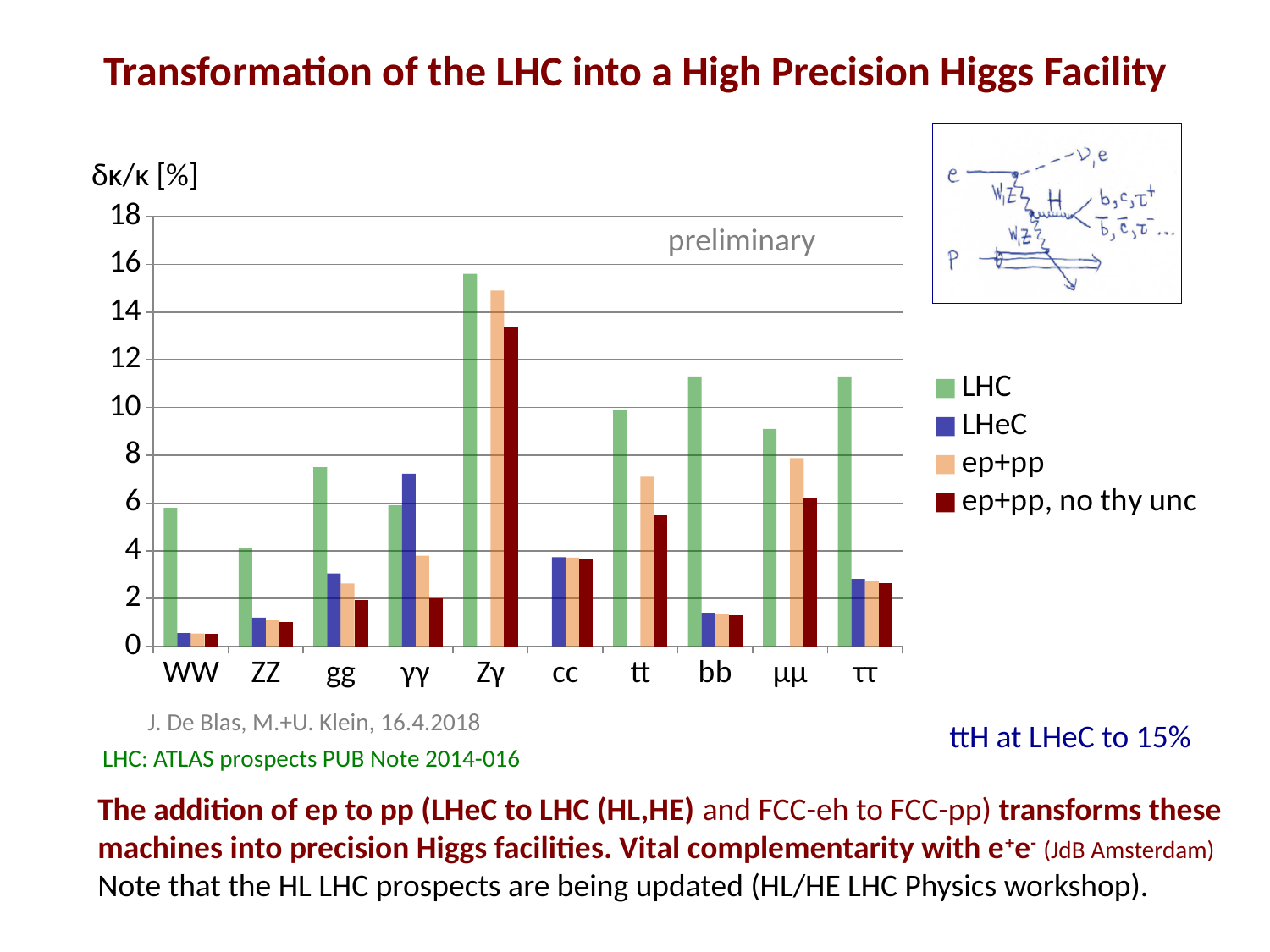
For which category is the LHC value highest? Zγ What is the label on the y axis of the chart? δκ/κ [%] How many series does the chart legend list? 4 Is the LHC value for Zγ greater or less than 14? greater What kind of chart is shown on the slide? bar chart How many categories are shown along the x axis of the chart? 10 For gg, which is larger: the LHC value or the LHeC value? LHC Is the LHC value for bb greater or less than 10? greater Which is larger: the LHC value for tt or the LHC value for bb? bb Is the ep+pp value for tt greater or less than 6? greater